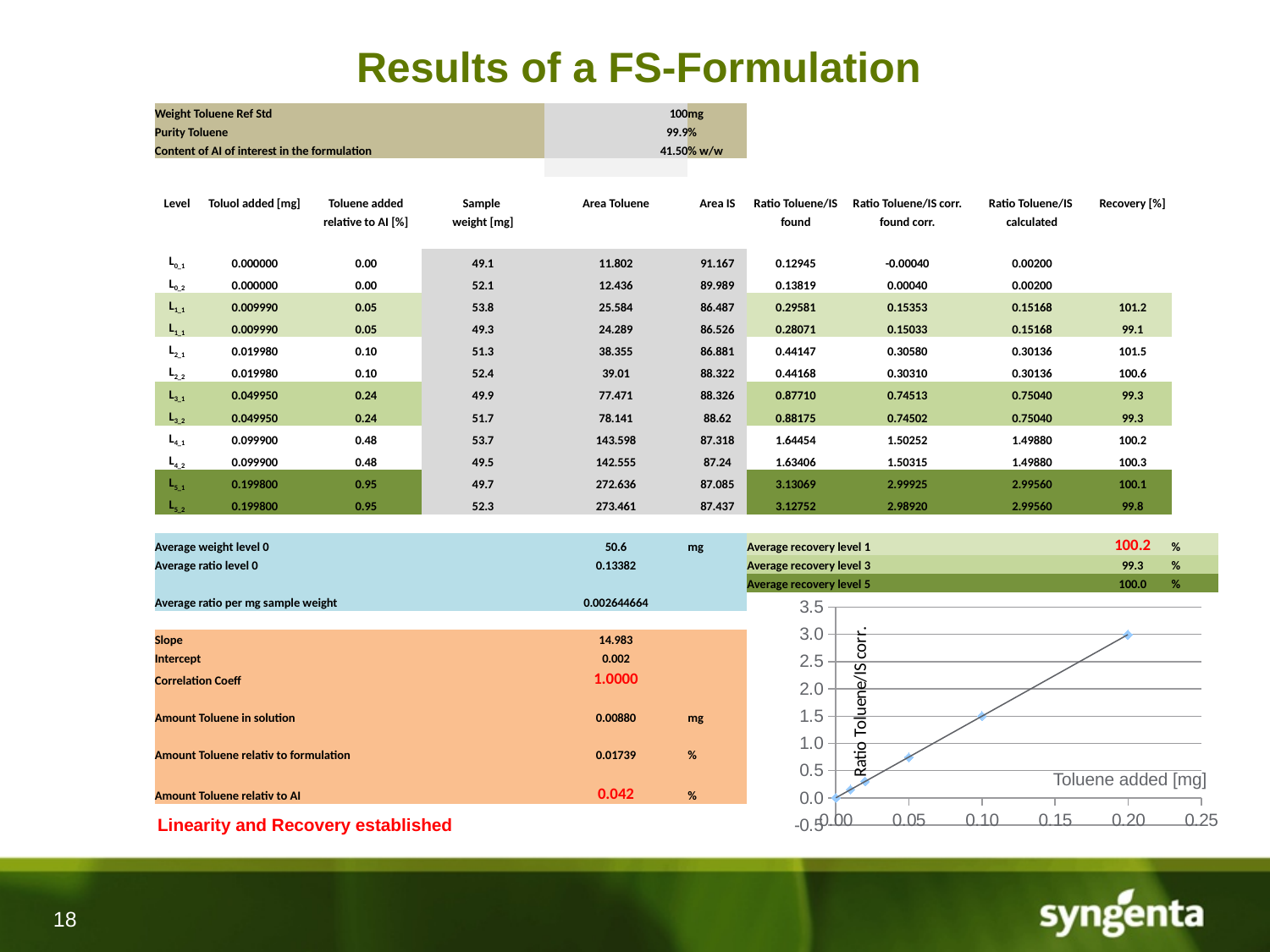
In the chart at the bottom right, do the values rise or fall as Toluene added increases along the x axis? rise In the chart at the bottom right, is the value at 0.05 mg Toluene added greater or less than 1.0? less What kind of chart is shown at the bottom right of the slide? scatter chart with a line What is the x-axis title of the chart at the bottom right? Toluene added [mg] In the chart at the bottom right, at which Toluene added value is the Ratio Toluene/IS corr. lowest? 0.00 In the chart at the bottom right, what is the maximum value shown on the y axis? 3.5 In the chart at the bottom right, is the value at 0.20 mg Toluene added greater or less than 2.5? greater In the chart at the bottom right, which has the larger Ratio Toluene/IS corr.: the point at 0.20 mg or the point at 0.10 mg Toluene added? 0.20 mg In the chart at the bottom right, at which Toluene added value is the Ratio Toluene/IS corr. highest? 0.20 In the chart at the bottom right, is the value at 0.10 mg Toluene added greater or less than 2.0? less What is the y-axis title of the chart at the bottom right? Ratio Toluene/IS corr.